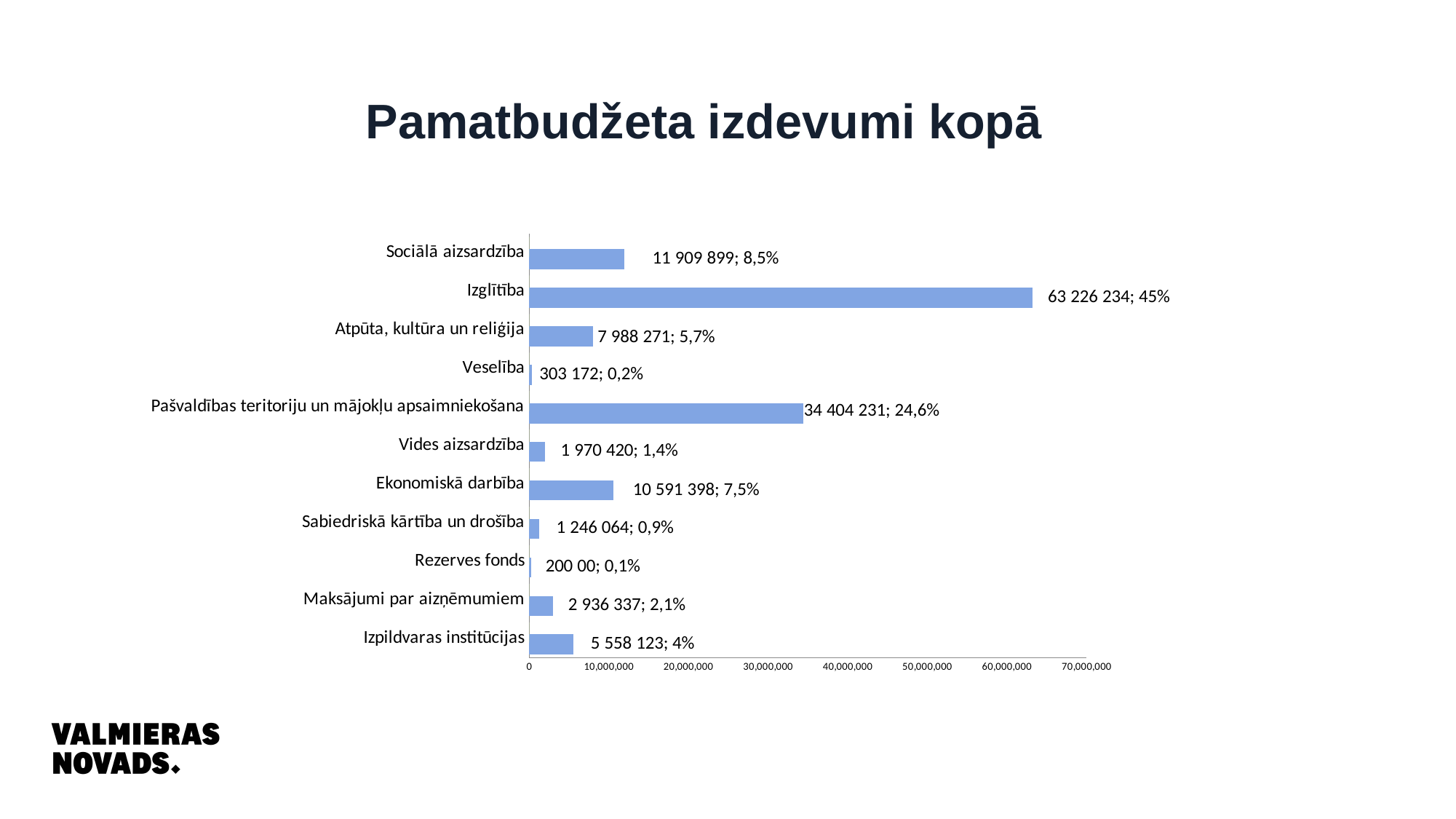
What type of chart is shown on the slide? Bar chart What value is shown for Izglītība? 63 226 234; 45% What is the difference between the values for Sociālā aizsardzība and Ekonomiskā darbība? 1 318 501 What is the difference between the values for Izglītība and Pašvaldības teritoriju un mājokļu apsaimniekošana? 28 822 003 Is the value for Pašvaldības teritoriju un mājokļu apsaimniekošana greater or less than 30,000,000? greater What value is shown for Ekonomiskā darbība? 10 591 398; 7,5% What percentage share is shown for Pašvaldības teritoriju un mājokļu apsaimniekošana? 24,6% Which category has the lowest expenditure? Rezerves fonds How many categories are shown in the chart? 11 What percentage is shown for Veselība? 0,2% Which is larger, the value for Atpūta, kultūra un reliģija or the value for Izpildvaras institūcijas? Atpūta, kultūra un reliģija Which category has the highest expenditure? Izglītība